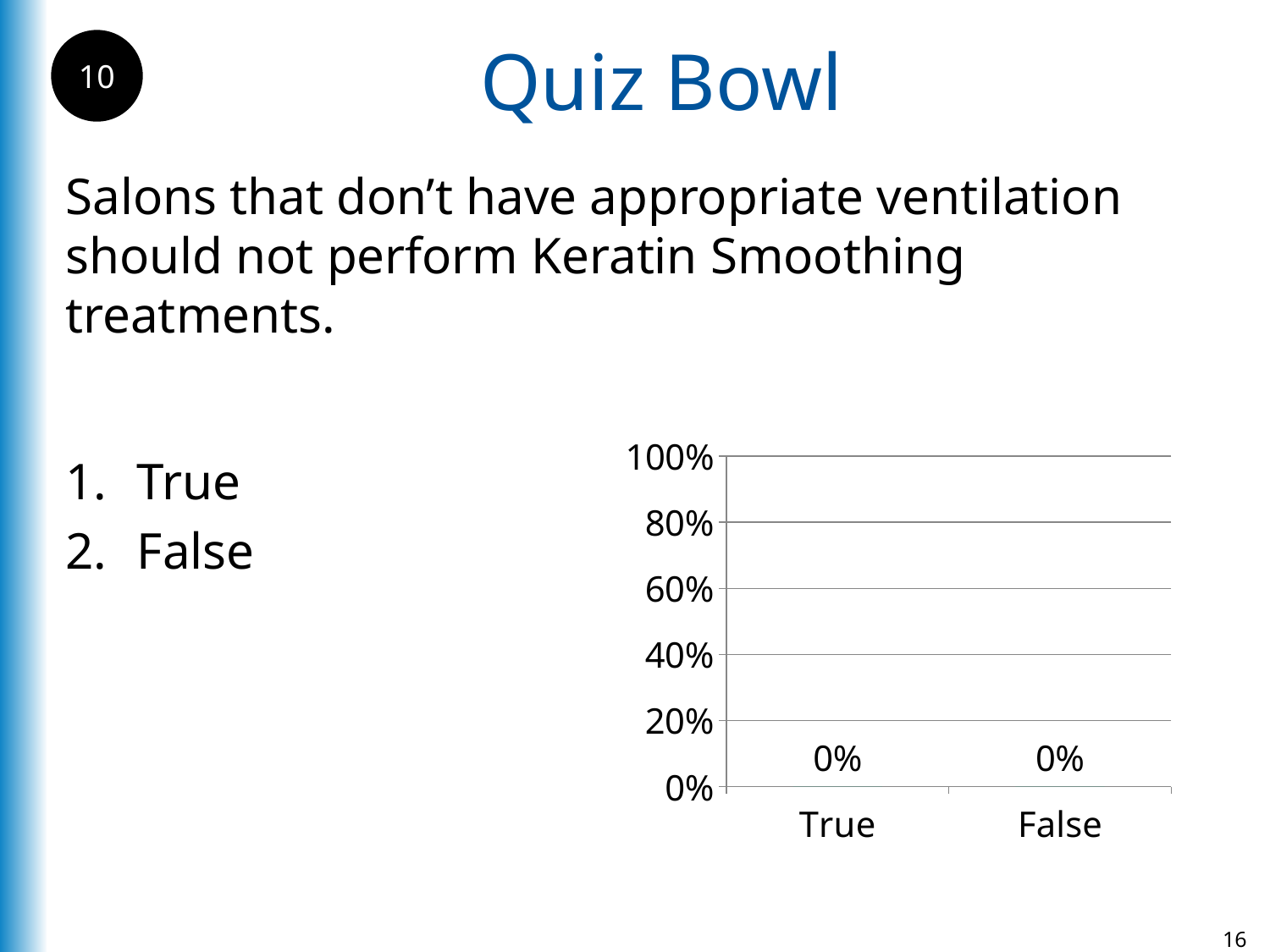
What is the value shown for True? 0% What kind of chart is shown on the slide? bar chart How many categories are shown on the x axis of the chart? 2 What are the two category labels on the x axis of the chart? True and False What is the difference between the values for True and False? 0% What is the value shown for False? 0% Is the value for False greater or less than 40%? less Is the value for True greater or less than 20%? less What is the highest value shown on the chart's vertical axis? 100%